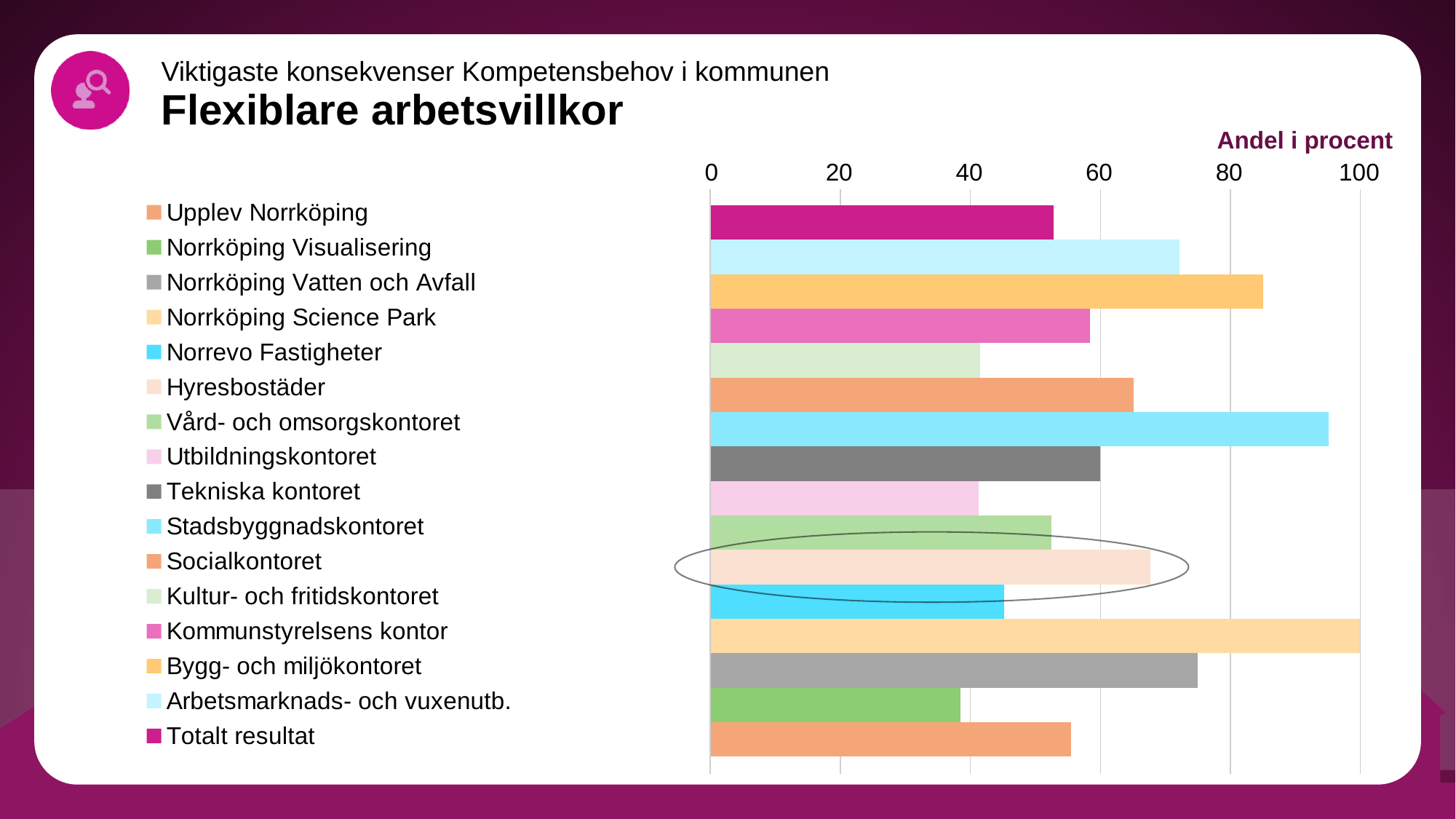
Is the value for Norrevo Fastigheter greater or less than 60? less How many bars are plotted in the chart? 16 How many entries does the legend list? 16 Which category has the highest value in the chart? Norrköping Science Park Is the value for Hyresbostäder greater or less than 60? greater Is the value for Norrköping Visualisering greater or less than 40? less Which category's bar is circled in the chart? Hyresbostäder What kind of chart is shown on the slide? bar chart What is the title shown above the horizontal axis of the chart? Andel i procent Which is larger, the value for Bygg- och miljökontoret or the value for Arbetsmarknads- och vuxenutb.? Bygg- och miljökontoret